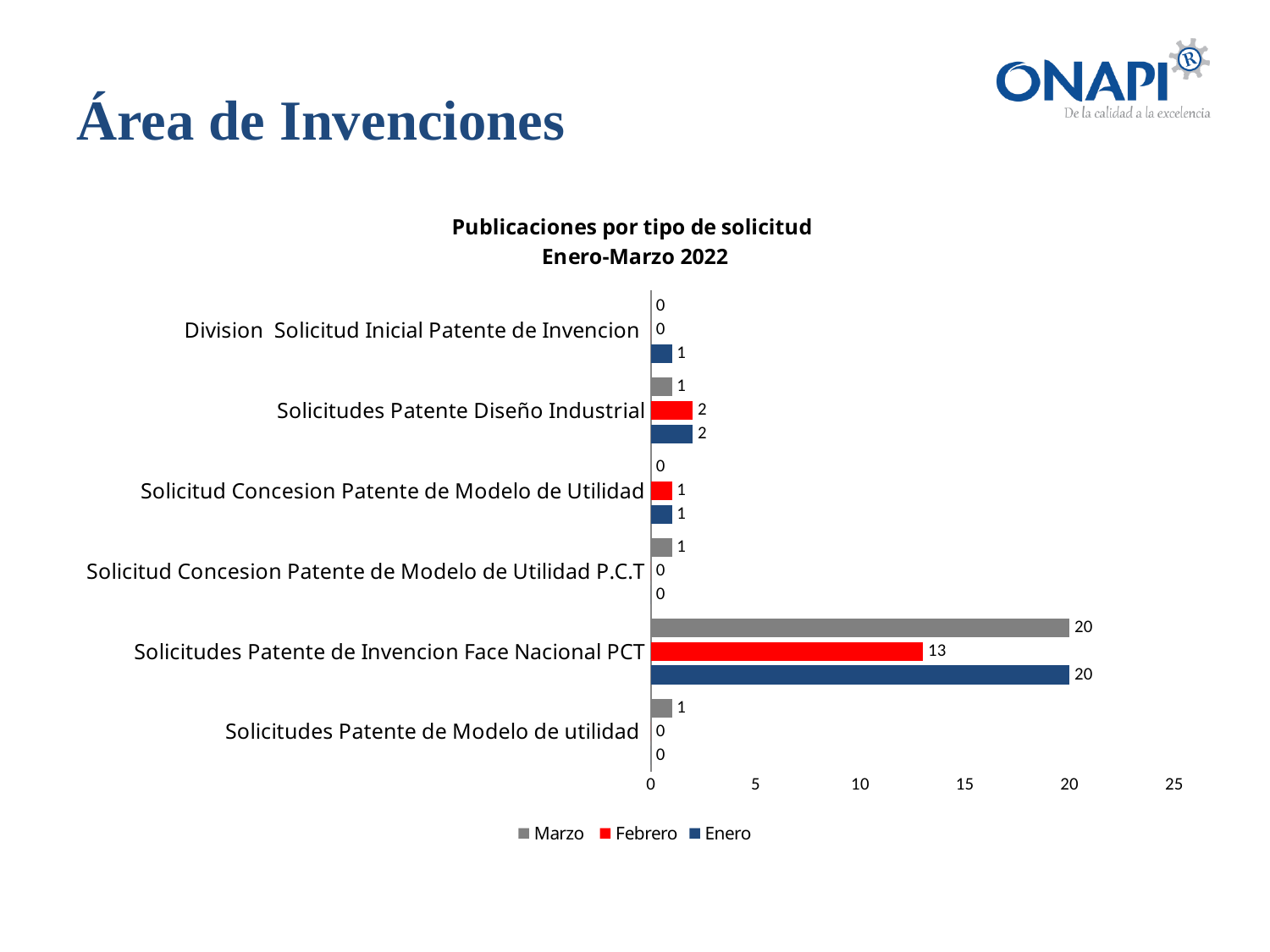
What is the Marzo value for Solicitudes Patente de Modelo de utilidad? 1 For Solicitud Concesion Patente de Modelo de Utilidad, is the Febrero value or the Marzo value larger? Febrero What is the Enero value for Solicitudes Patente Diseño Industrial? 2 What is the title of the chart? Publicaciones por tipo de solicitud Enero-Marzo 2022 What is the difference between the Marzo and Febrero values for Solicitudes Patente de Invencion Face Nacional PCT? 7 What is the total of the three months' values for Solicitudes Patente de Invencion Face Nacional PCT? 53 How many series does the legend list? 3 What is the Febrero value for Solicitudes Patente de Invencion Face Nacional PCT? 13 What is the Enero value for Division Solicitud Inicial Patente de Invencion? 1 What kind of chart is shown? Bar chart Which category has the highest Marzo value? Solicitudes Patente de Invencion Face Nacional PCT How many categories are shown on the chart? 6